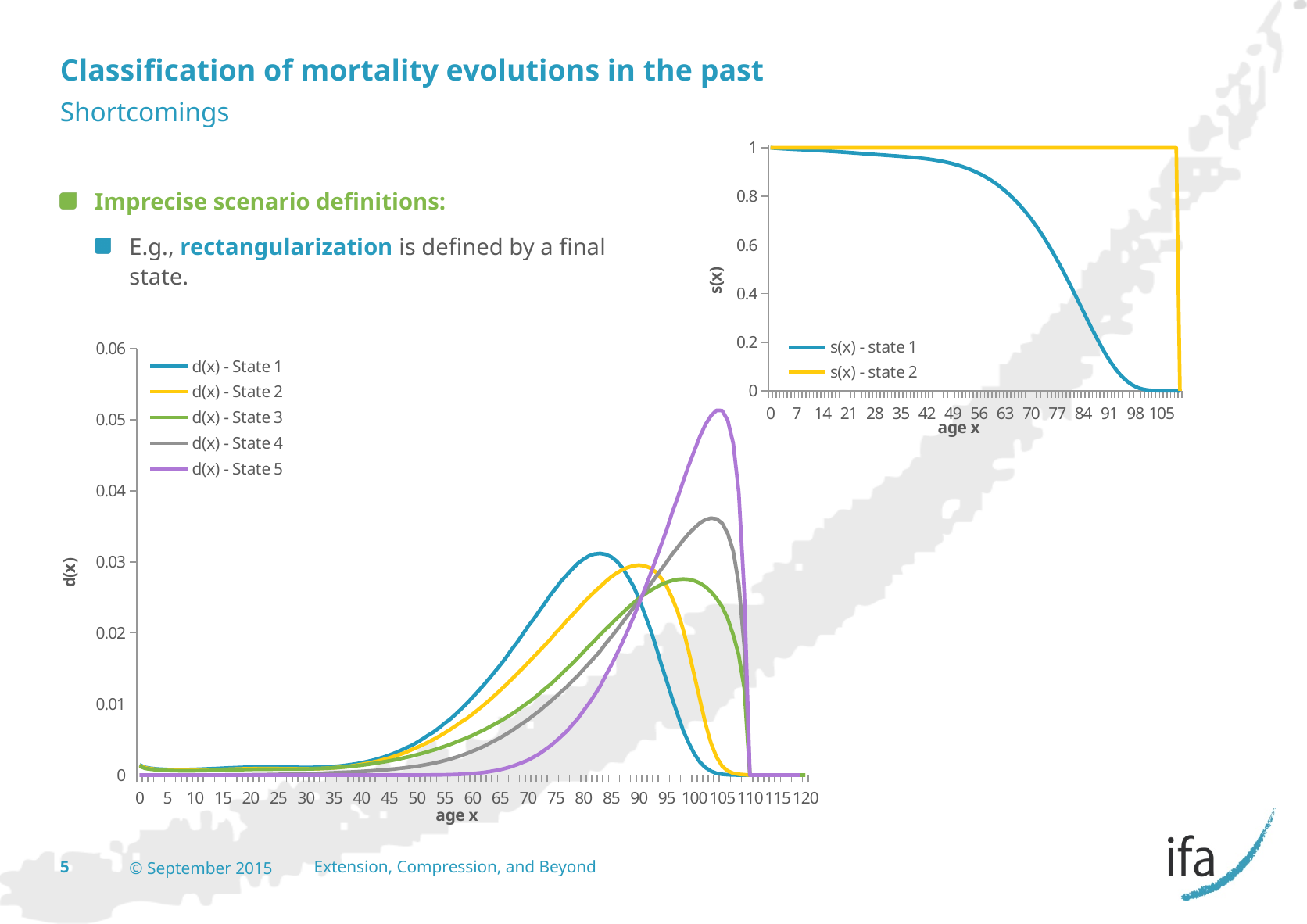
In the d(x) chart, is the peak value of d(x) - State 5 greater or less than 0.04? greater In the d(x) chart, is the peak value of d(x) - State 4 greater or less than 0.03? greater In the d(x) chart, is the peak value of d(x) - State 1 greater or less than 0.04? less In the s(x) chart, does the s(x) - state 1 line rise or fall as age x increases? fall In the d(x) chart, which series has the higher peak: d(x) - State 4 or d(x) - State 1? d(x) - State 4 In the s(x) chart, what is the value of s(x) - state 2 at age 49? 1 In the d(x) chart, which series reaches the highest peak value? d(x) - State 5 How many series does the legend of the s(x) chart in the top right list? 2 What kind of chart is the large d(x) chart on the left of the slide? line chart How many series does the legend of the d(x) chart list? 5 What is the x-axis label of the d(x) chart? age x